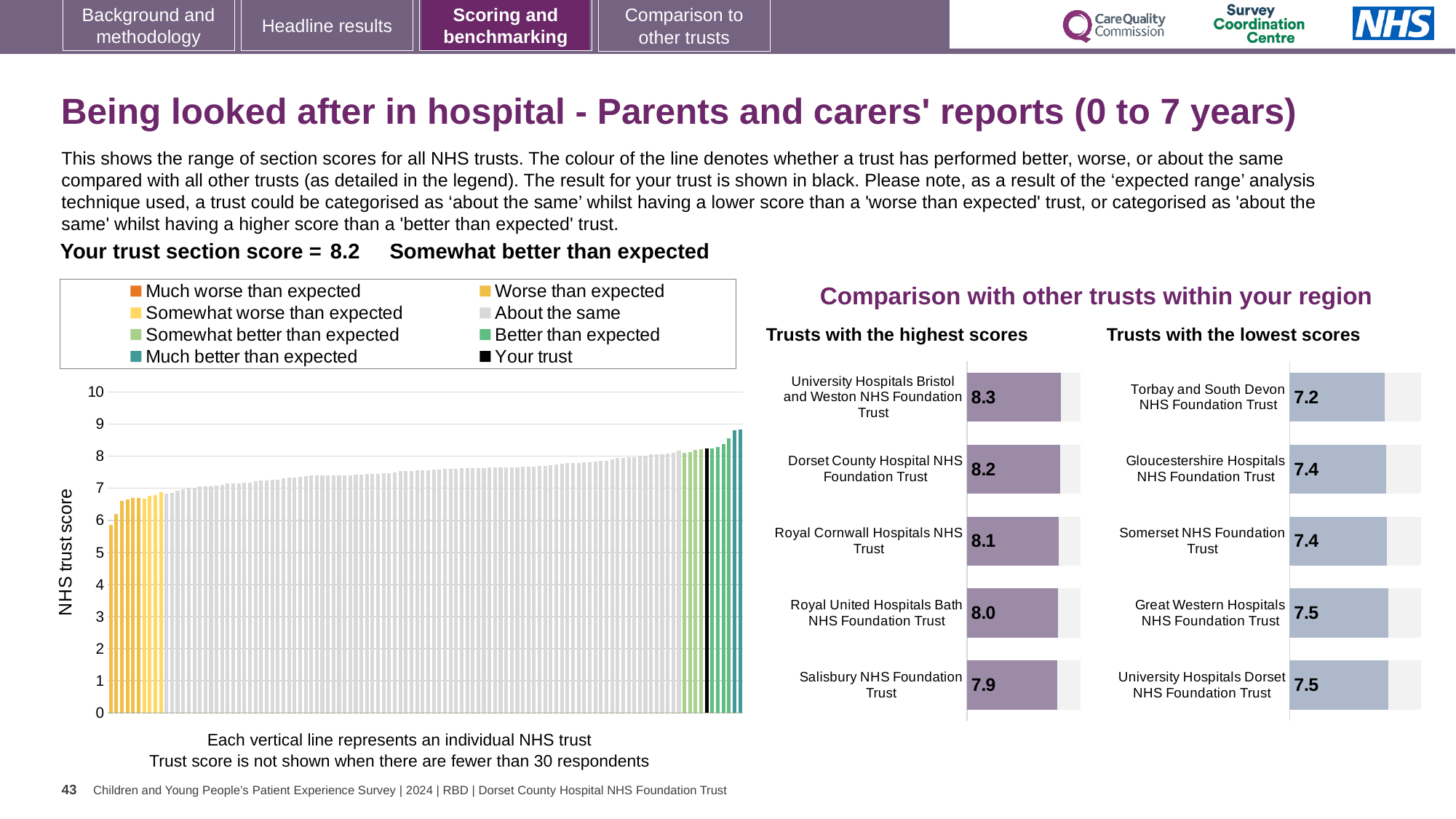
In the 'Trusts with the lowest scores' chart, what is the score for Torbay and South Devon NHS Foundation Trust? 7.2 In the 'Trusts with the highest scores' chart, what is the score for Salisbury NHS Foundation Trust? 7.9 How many trusts are shown in the 'Trusts with the highest scores' chart? 5 What kind of chart is the main chart on the left showing NHS trust scores? Bar chart In the 'Trusts with the lowest scores' chart, what is the score for Great Western Hospitals NHS Foundation Trust? 7.5 In the 'Trusts with the highest scores' chart, which trust has the highest score? University Hospitals Bristol and Weston NHS Foundation Trust In the 'Trusts with the highest scores' chart, what is the difference between the scores of University Hospitals Bristol and Weston NHS Foundation Trust and Salisbury NHS Foundation Trust? 0.4 In the 'Trusts with the lowest scores' chart, which has the larger score: Torbay and South Devon NHS Foundation Trust or Gloucestershire Hospitals NHS Foundation Trust? Gloucestershire Hospitals NHS Foundation Trust In the main chart on the left, is the value for the tallest bar greater or less than 8? greater In the 'Trusts with the highest scores' chart, what is the score for University Hospitals Bristol and Weston NHS Foundation Trust? 8.3 How many entries does the legend of the main chart on the left list? 8 In the 'Trusts with the lowest scores' chart, which trust has the lowest score? Torbay and South Devon NHS Foundation Trust